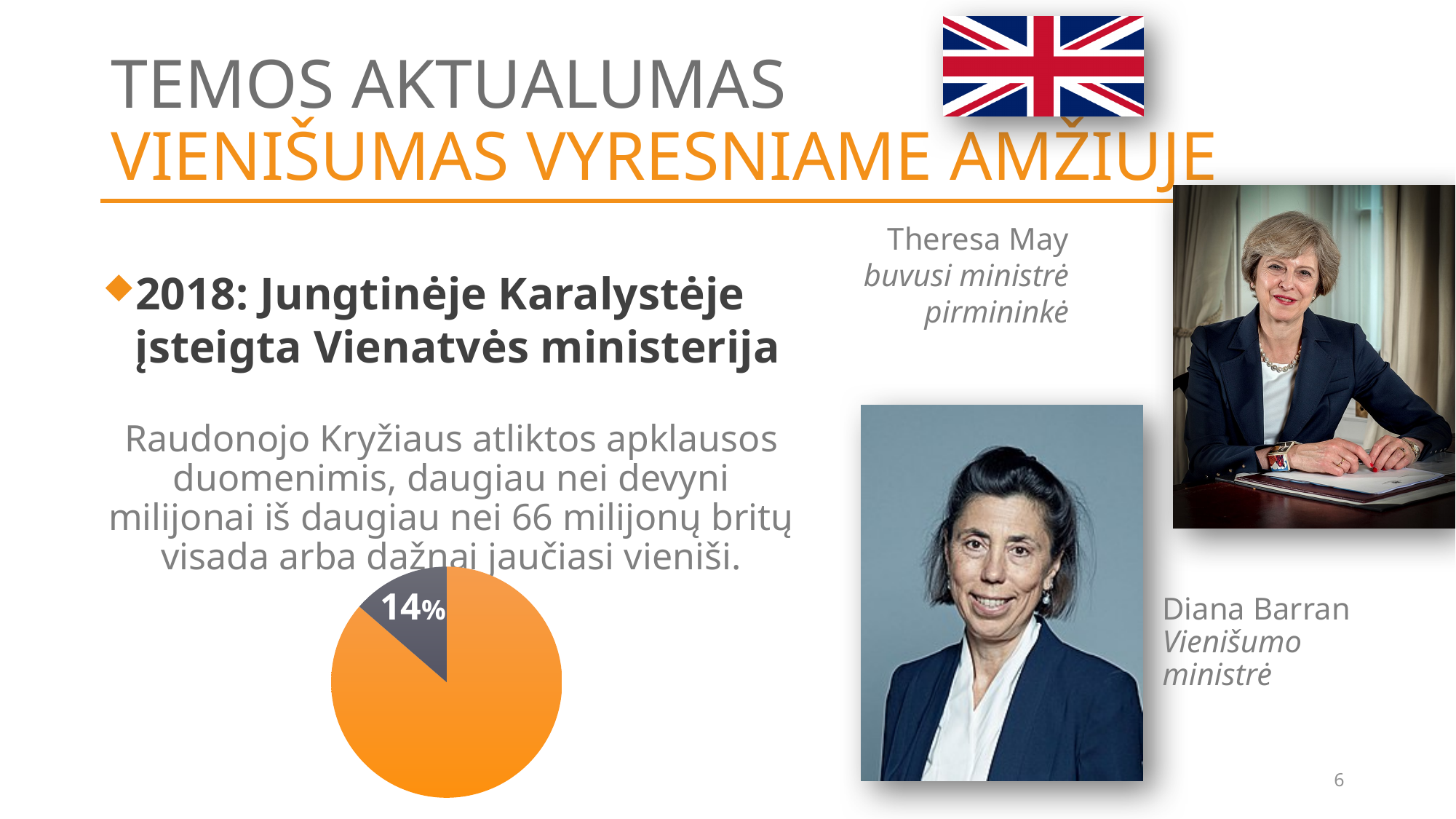
What share of the pie does the labelled slice represent? 14% Which colour slice is the smallest in the pie chart? grey Which slice of the pie chart is larger, the orange one or the grey one? orange Which colour slice is the largest in the pie chart? orange What kind of chart is shown on the slide? pie chart Is the orange slice of the pie chart greater or less than 50% of the pie? greater What colour is the slice labelled 14%? grey How many slices does the pie chart have? 2 Does the pie chart have a legend? No What value is printed on the grey slice of the pie chart? 14%